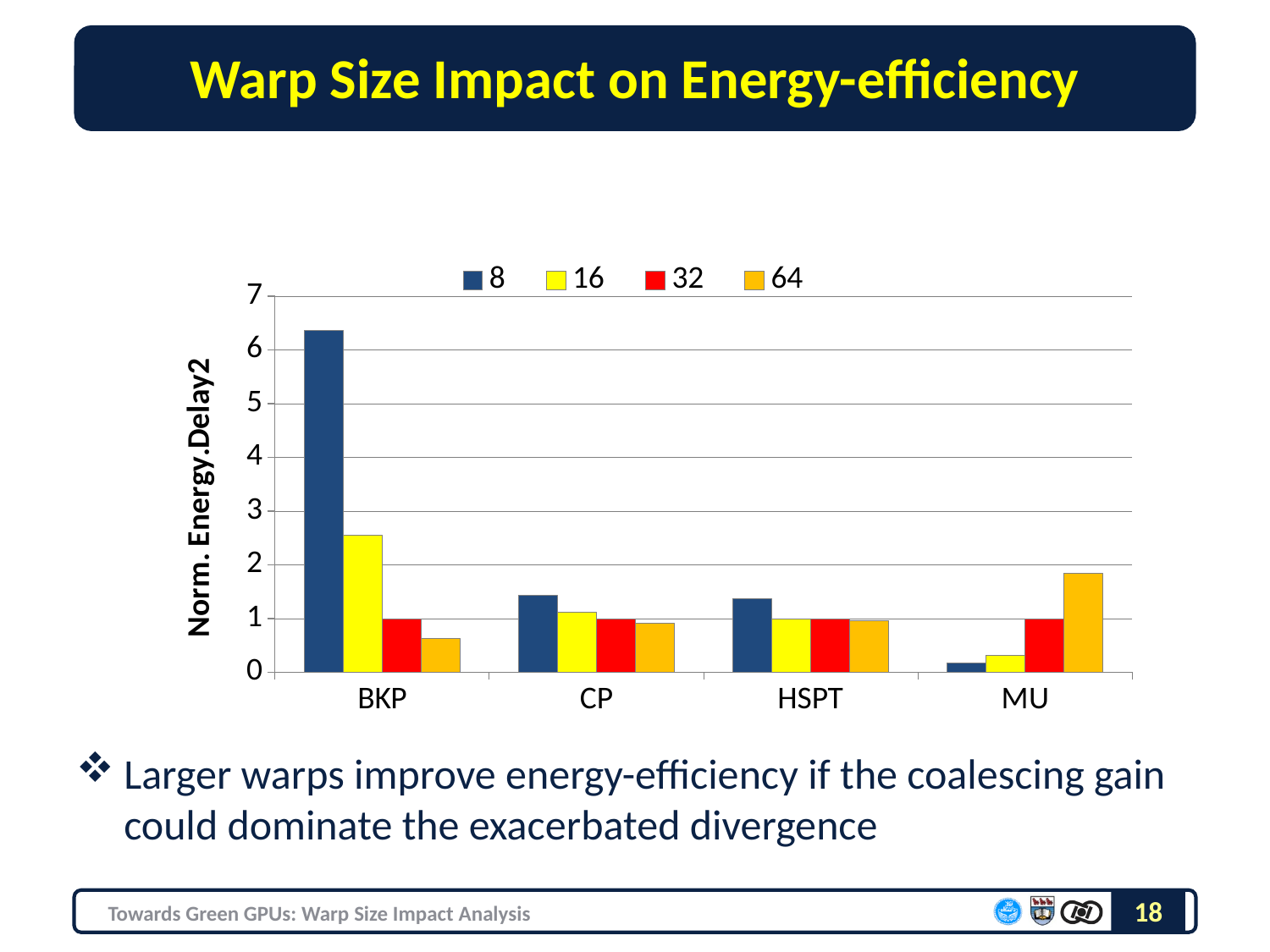
How many series does the chart's legend list? 4 Is the value for MU in the series 8 greater or less than 1? less For BKP, do the values rise or fall as the warp size increases from 8 to 64? fall How many categories are shown on the x axis of the chart? 4 What kind of chart is shown on the slide? bar chart Which category has the highest value for the series 8? BKP What is the title of the y axis? Norm. Energy.Delay2 What entries are listed in the chart's legend? 8, 16, 32, 64 Is the value for BKP in the series 8 greater or less than 6? greater For MU, which series has the larger value, 8 or 64? 64 Which category has the lowest value for the series 8? MU Is the value for BKP in the series 16 greater or less than 2? greater